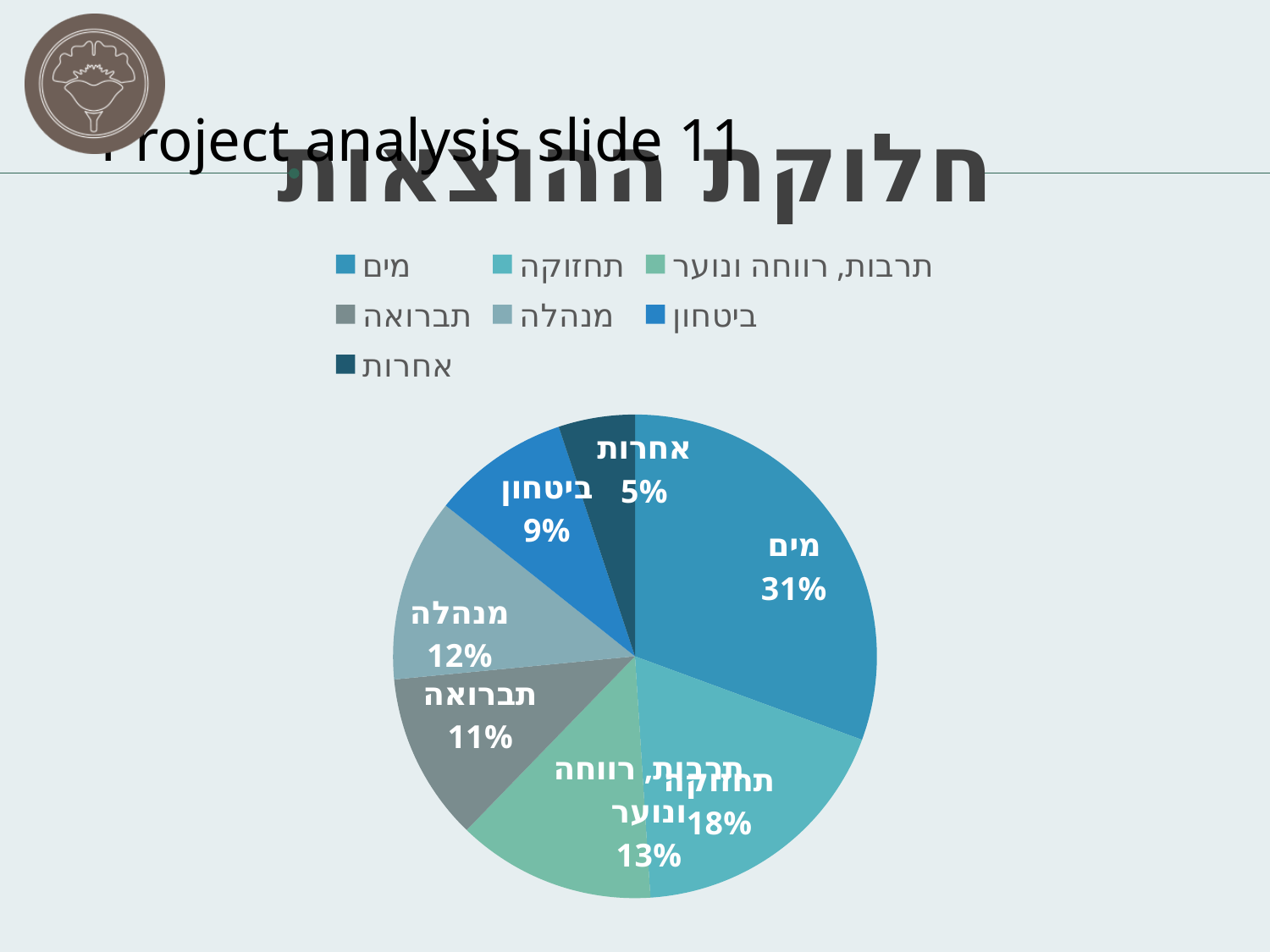
What percentage of the pie is the מנהלה slice? 12% How many entries does the legend list? 7 Which category has the largest share of the pie? מים What is the difference in percentage points between the מים slice and the תחזוקה slice? 13 Which slice is larger, תברואה or תרבות, רווחה ונוער? תרבות, רווחה ונוער What kind of chart is shown on the slide? pie chart What percentage of the pie is the תחזוקה slice? 18% What is the title of the chart? חלוקת ההוצאות Which category has the smallest share of the pie? אחרות How many slices does the pie chart have? 7 What percentage of the pie is the ביטחון slice? 9% What percentage of the pie is the מים slice? 31%